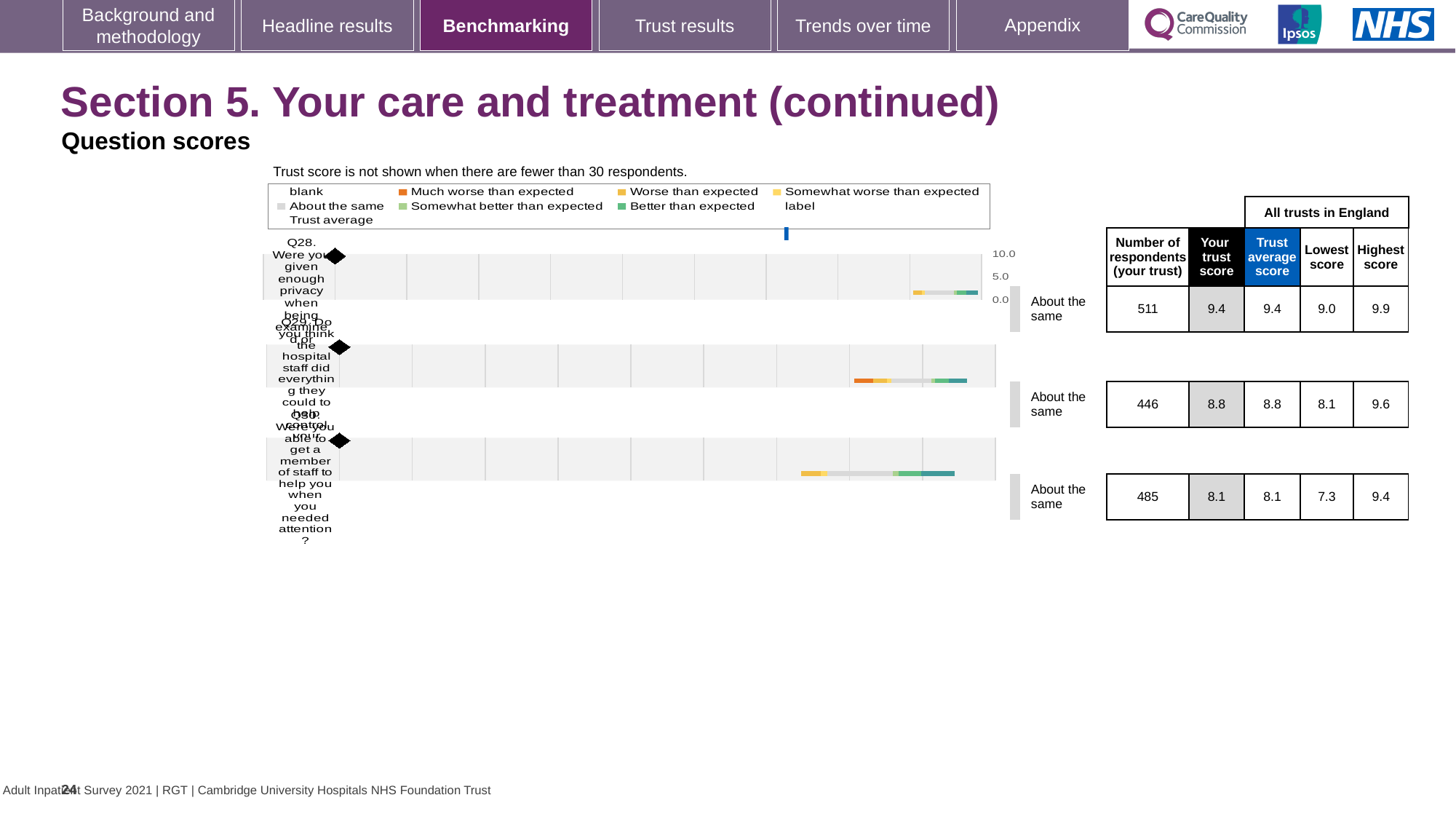
How many question charts are shown on the slide? 3 What is the difference between the highest score and the lowest score for Q28? 0.9 Is the trust score for Q29 larger or smaller than the trust score for Q30? larger What benchmark category is shown for Q28's trust score? About the same What is the lowest score across all trusts in England for Q30? 7.3 What is the trust score for Q28 (Were you given enough privacy when being examined or treated)? 9.4 Which of the three questions shown (Q28, Q29, Q30) has the highest trust score? Q28 How many respondents answered Q30? 485 What is the trust score for Q30 (Were you able to get a member of staff to help you when you needed attention)? 8.1 What is the trust score for Q29 (Do you think the hospital staff did everything they could to help control your pain)? 8.8 Which of the three questions shown (Q28, Q29, Q30) has the lowest trust score? Q30 What is the highest score across all trusts in England for Q29? 9.6